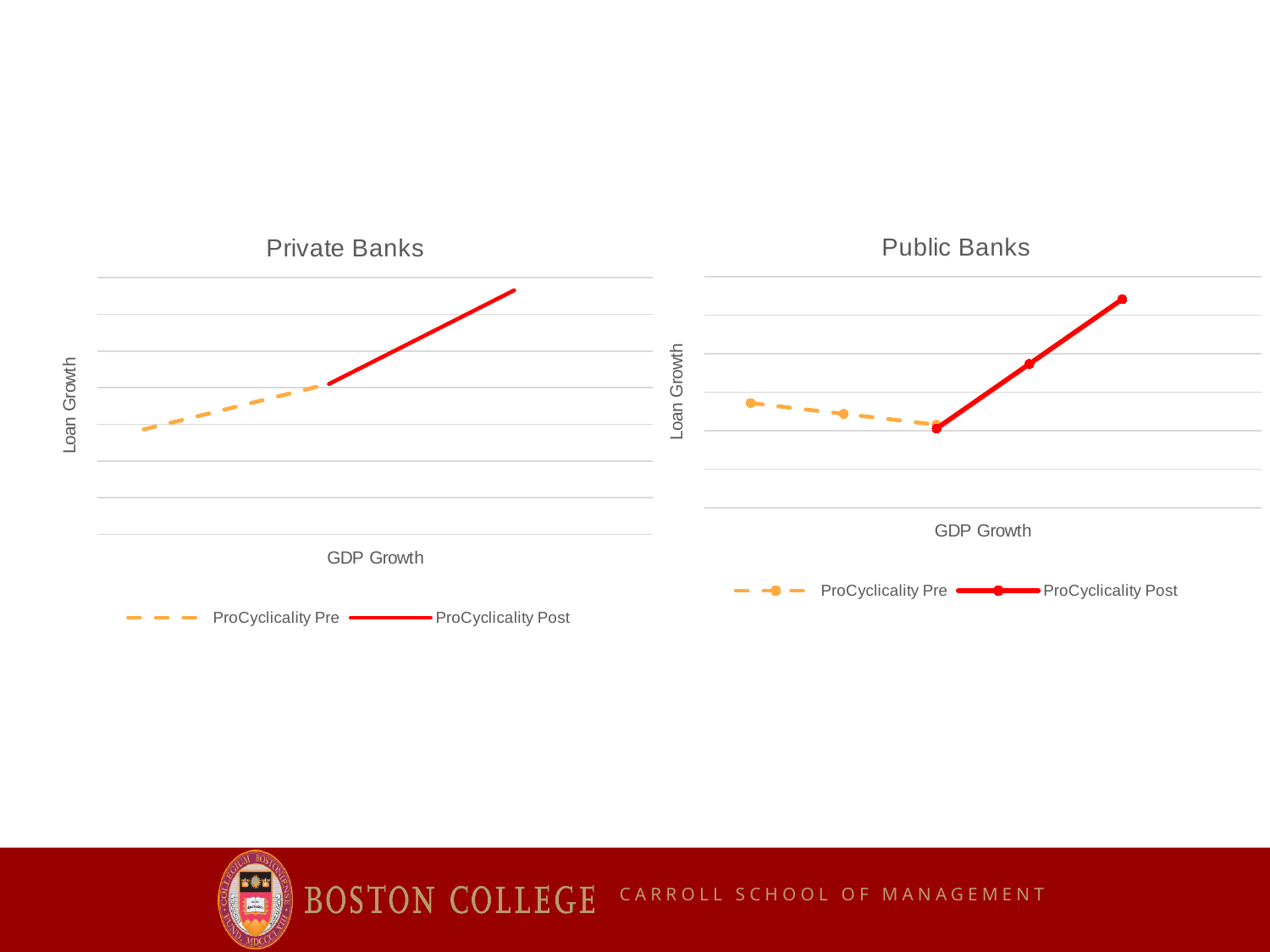
In the Private Banks chart, does the ProCyclicality Pre line rise or fall as GDP Growth increases? rise What is the label on the vertical axis of the Public Banks chart? Loan Growth In the Public Banks chart, how many marked points are on the ProCyclicality Post line? 3 In the Public Banks chart, does the ProCyclicality Pre line rise or fall as GDP Growth increases? fall In the Public Banks chart, which is higher: the right end of the ProCyclicality Post line or the left end of the ProCyclicality Pre line? the right end of the ProCyclicality Post line In the Private Banks chart, does the ProCyclicality Post line rise or fall as GDP Growth increases? rise What is the label on the horizontal axis of the Private Banks chart? GDP Growth How many series does the legend of the Public Banks chart list? 2 What kind of chart is the Public Banks chart? line chart What kind of chart is the Private Banks chart? line chart How many series does the legend of the Private Banks chart list? 2